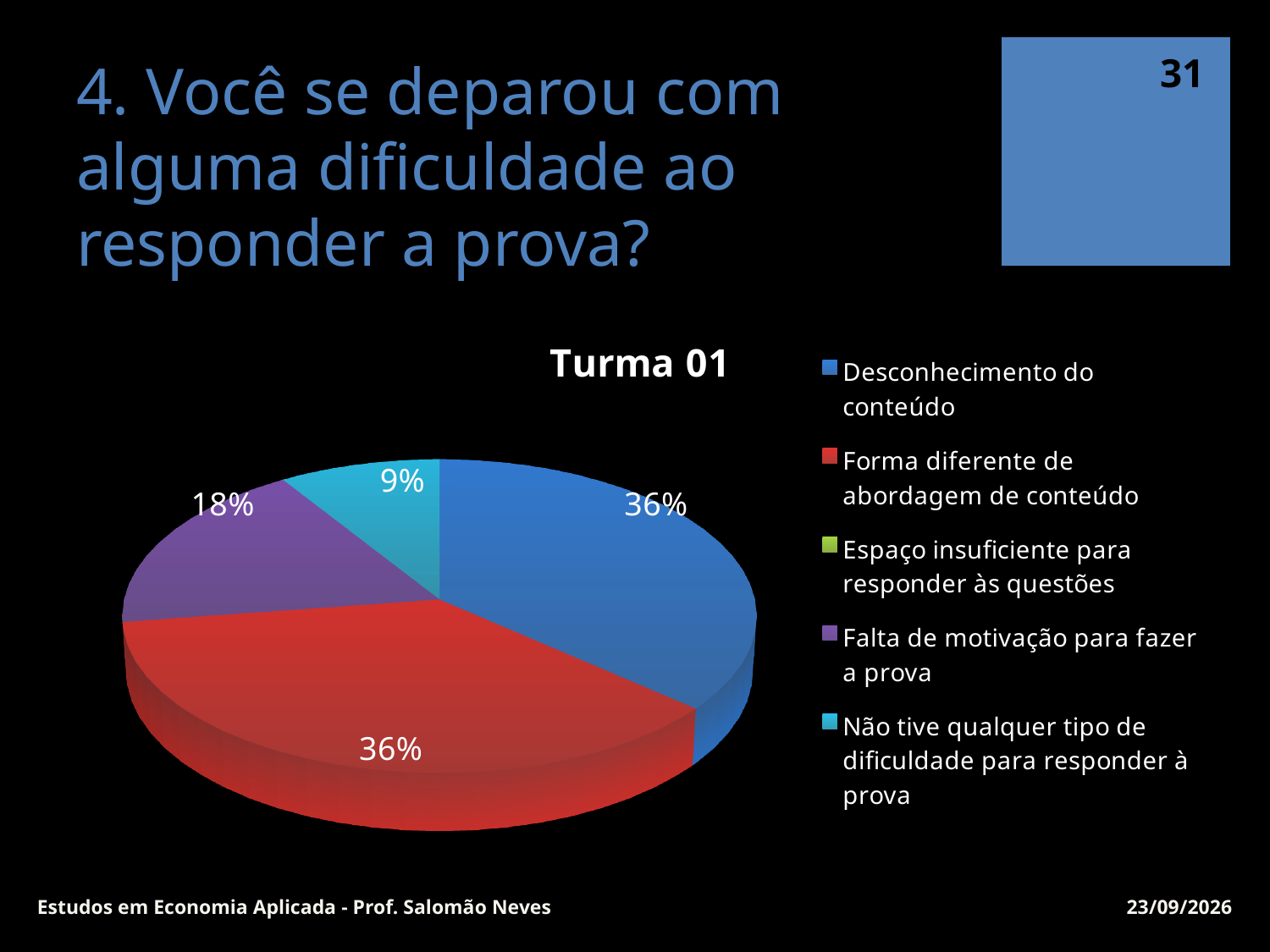
What share of the pie does "Falta de motivação para fazer a prova" represent? 18% What share of the pie does "Desconhecimento do conteúdo" represent? 36% What share of the pie does "Forma diferente de abordagem de conteúdo" represent? 36% What kind of chart is shown on the slide? Pie chart What colour is the slice for "Forma diferente de abordagem de conteúdo"? Red What share of the pie does "Não tive qualquer tipo de dificuldade para responder à prova" represent? 9% Which is larger: the slice for "Falta de motivação para fazer a prova" or the slice for "Não tive qualquer tipo de dificuldade para responder à prova"? Falta de motivação para fazer a prova What is the title of the chart? Turma 01 By how many percentage points does the "Desconhecimento do conteúdo" slice exceed the "Falta de motivação para fazer a prova" slice? 18 percentage points How many entries does the chart's legend list? 5 By how many percentage points does the "Falta de motivação para fazer a prova" slice exceed the "Não tive qualquer tipo de dificuldade para responder à prova" slice? 9 percentage points